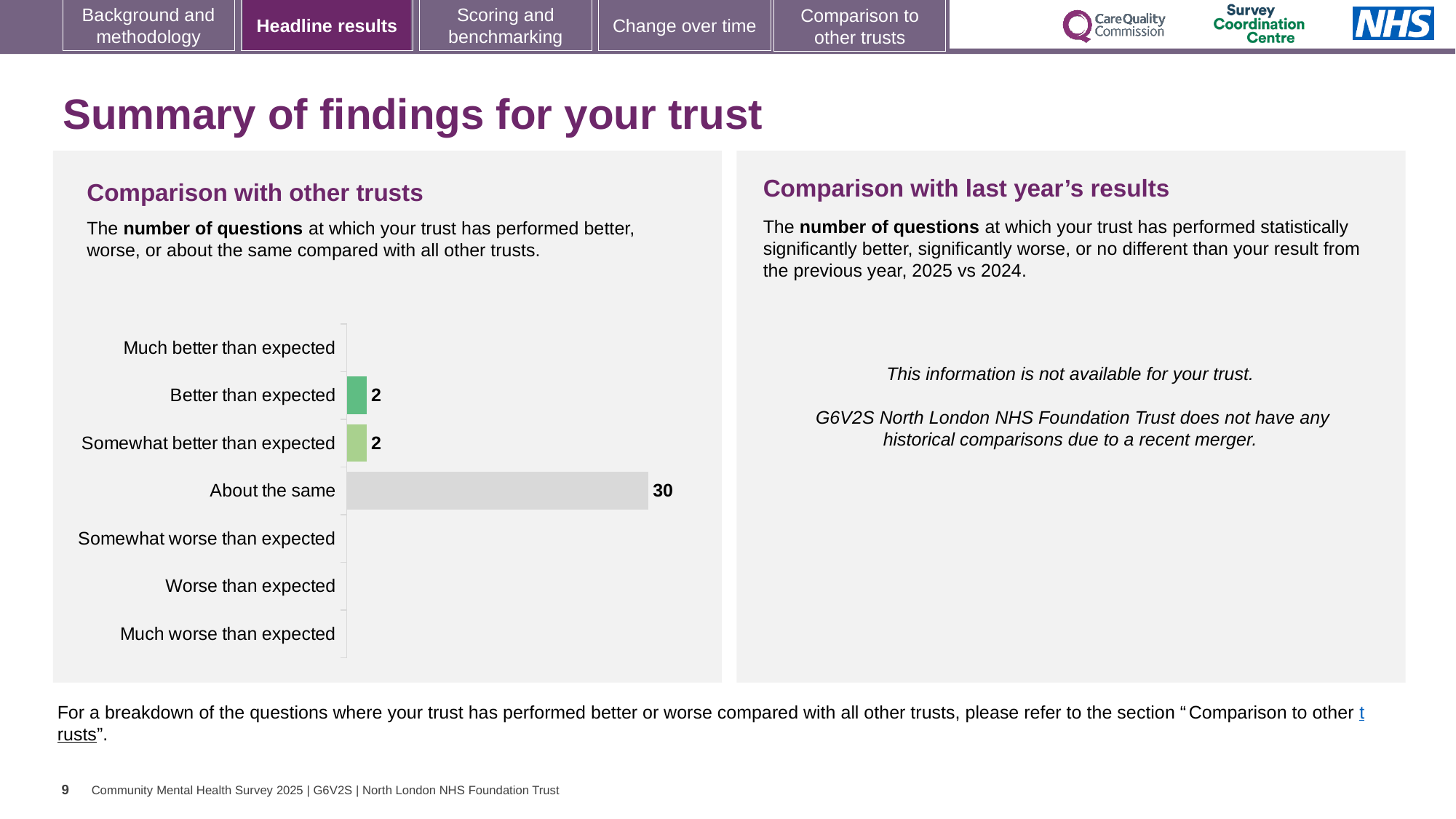
In the Comparison with other trusts chart, which is larger: the value for 'About the same' or the value for 'Somewhat better than expected'? About the same What is the value for 'Somewhat better than expected' in the Comparison with other trusts chart? 2 Which category has the highest value in the Comparison with other trusts chart? About the same What kind of chart is shown under 'Comparison with other trusts'? Bar chart What is the value for 'Better than expected' in the Comparison with other trusts chart? 2 How many categories in the Comparison with other trusts chart have a visible bar? 3 What is the value for 'About the same' in the Comparison with other trusts chart? 30 What colour is the bar for 'About the same' in the Comparison with other trusts chart? Grey What is the title of the chart on the left side of the slide? Comparison with other trusts How many categories are listed on the axis of the Comparison with other trusts chart? 7 What is the difference between the values for 'About the same' and 'Better than expected' in the Comparison with other trusts chart? 28